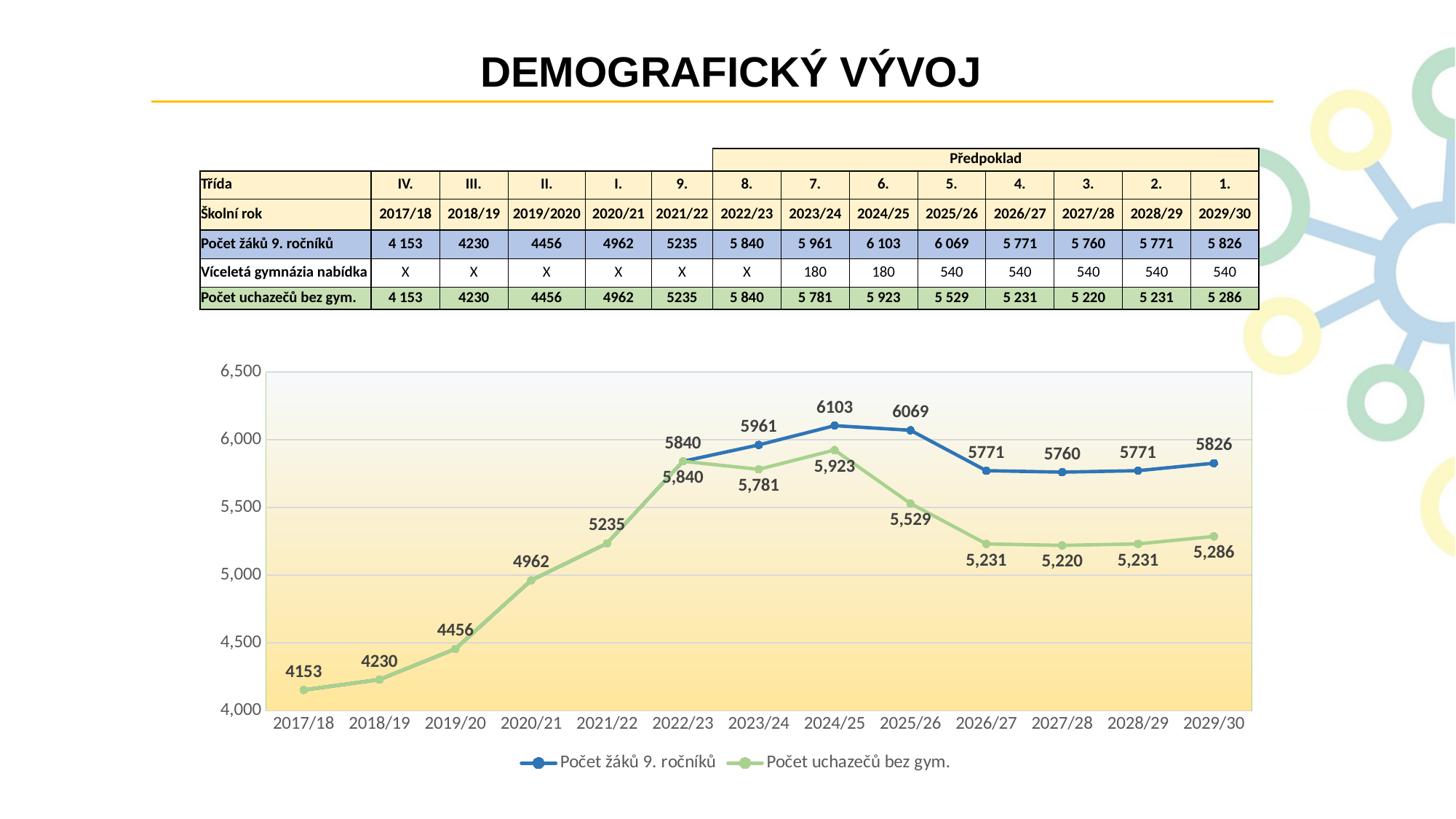
In which school year is Počet uchazečů bez gym. lowest in the chart? 2017/18 What is the value of Počet žáků 9. ročníků for 2024/25 in the chart? 6103 How many school years are plotted along the x axis of the chart? 13 What is the difference between Počet žáků 9. ročníků and Počet uchazečů bez gym. in 2029/30? 540 Which is larger in 2025/26: Počet žáků 9. ročníků or Počet uchazečů bez gym.? Počet žáků 9. ročníků Does Počet uchazečů bez gym. rise or fall between 2017/18 and 2022/23? rise What is the value of Počet uchazečů bez gym. for 2027/28 in the chart? 5,220 How many series does the chart legend list? 2 In which school year does Počet žáků 9. ročníků reach its highest value in the chart? 2024/25 What is the value of Počet uchazečů bez gym. for 2017/18 in the chart? 4153 Is the value of Počet uchazečů bez gym. for 2020/21 greater or less than 5,000? less What kind of chart is shown on the slide? line chart